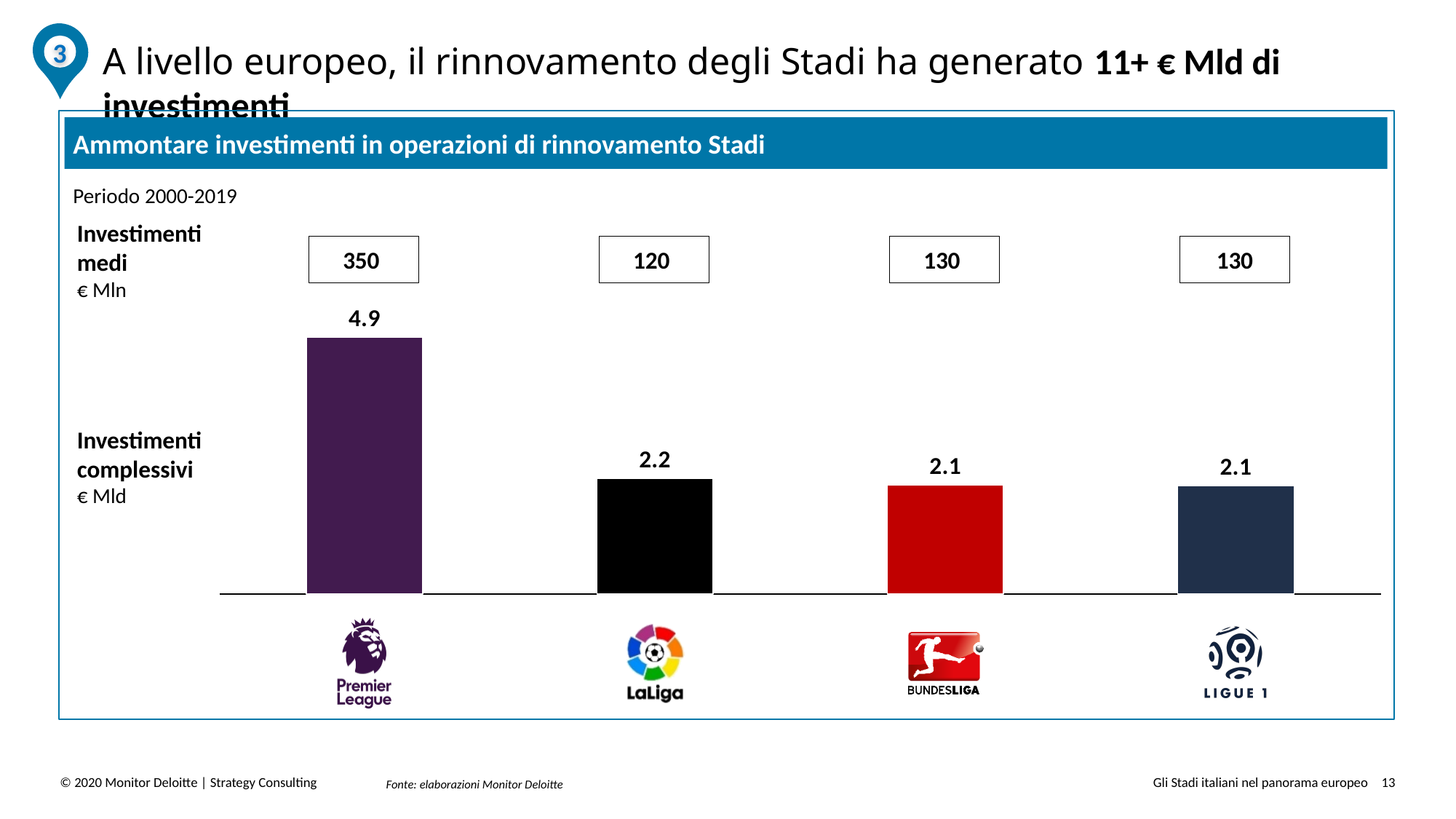
Which league has the lowest average investment (Investimenti medi) in the chart? LaLiga What is the average investment (Investimenti medi, € Mln) shown for LaLiga? 120 Which league has the highest total investment in the chart? Premier League What is the title of the chart? Ammontare investimenti in operazioni di rinnovamento Stadi What kind of chart is shown on the slide? Bar chart What is the average investment (Investimenti medi, € Mln) shown for the Premier League? 350 What is the total investment (Investimenti complessivi, € Mld) shown for LaLiga? 2.2 Which has a larger total investment, LaLiga or the Bundesliga? LaLiga What is the difference in total investment (€ Mld) between the Premier League and LaLiga? 2.7 How many leagues are shown in the chart? 4 What is the total investment (Investimenti complessivi, € Mld) shown for the Bundesliga? 2.1 What is the total investment (Investimenti complessivi, € Mld) shown for the Premier League? 4.9